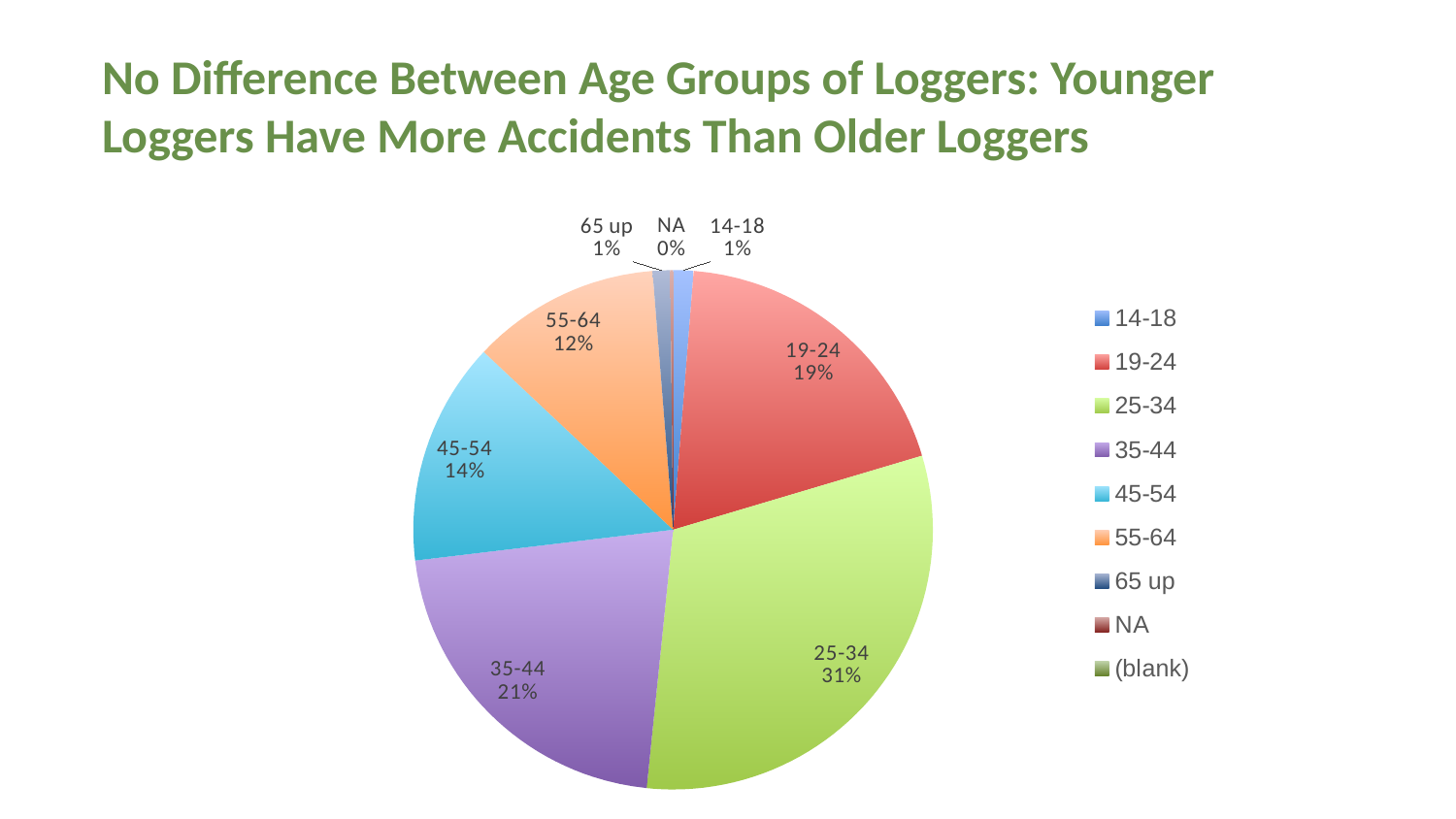
Which slice is larger, 45-54 or 55-64? 45-54 How many entries does the legend list? 9 What share of the pie does the 25-34 age group have? 31% What kind of chart is shown on the slide? pie chart What percentage is shown for the 19-24 age group? 19% Which category has the smallest share, at 0%? NA What percentage is shown for the 55-64 age group? 12% What percentage is shown for the 45-54 age group? 14% What is the combined share of the 19-24 and 25-34 slices? 50% Which age group has the largest slice of the pie? 25-34 What share of the pie does the 35-44 age group have? 21% What is the difference in percentage points between the 25-34 and 35-44 slices? 10